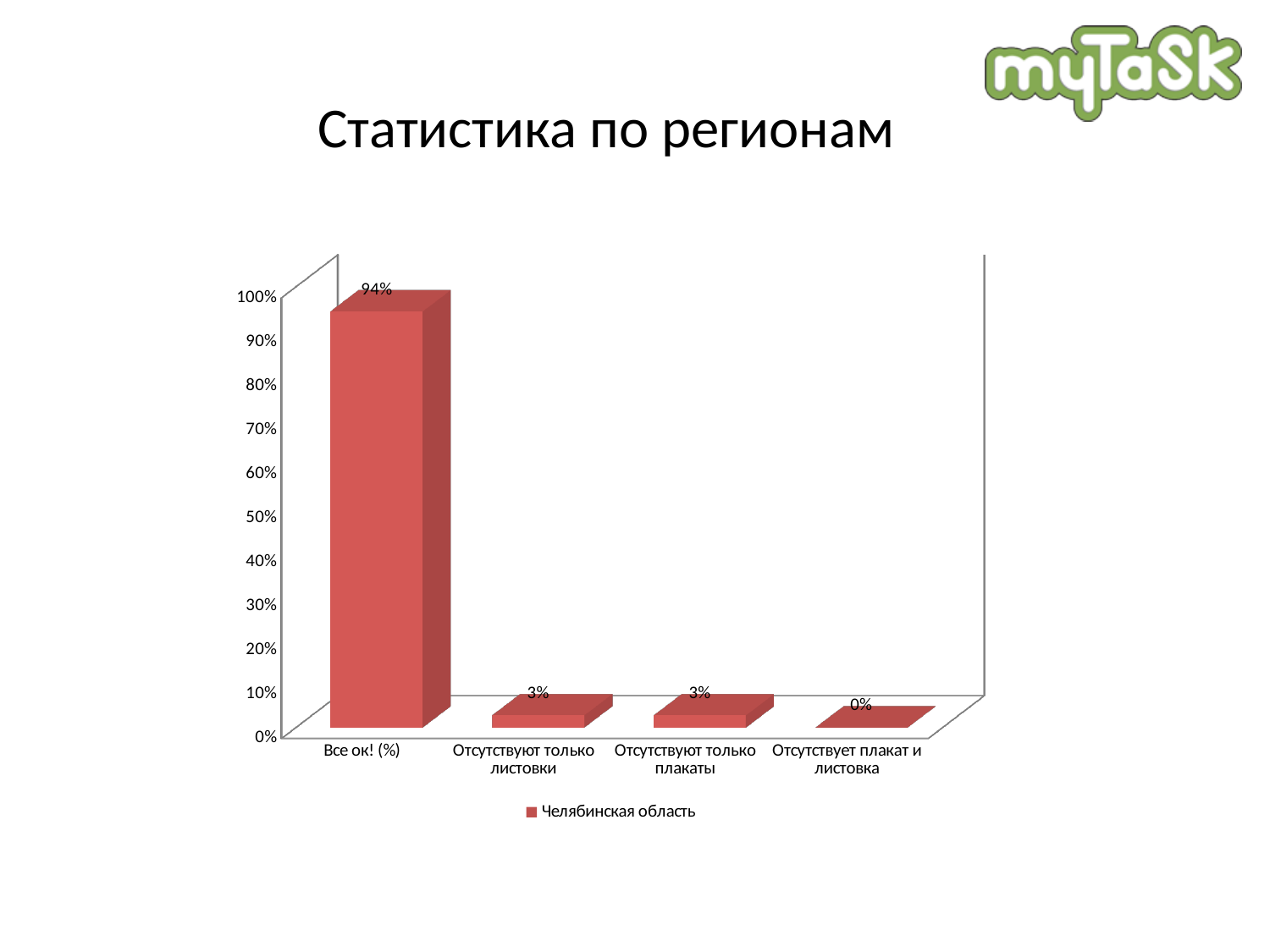
What kind of chart is shown on the slide? bar chart What series name is shown in the legend? Челябинская область Which category has the highest value? Все ок! (%) Which category has the lowest value? Отсутствует плакат и листовка How many categories are shown on the x axis? 4 How many series does the legend list? 1 What is the difference between the values for "Все ок! (%)" and "Отсутствуют только плакаты"? 91% What is the value for "Отсутствует плакат и листовка"? 0% What is the value for "Отсутствуют только листовки"? 3% Which is larger: the value for "Все ок! (%)" or the value for "Отсутствуют только листовки"? Все ок! (%) What is the value for "Все ок! (%)"? 94% Is the value for "Все ок! (%)" greater or less than 50%? greater